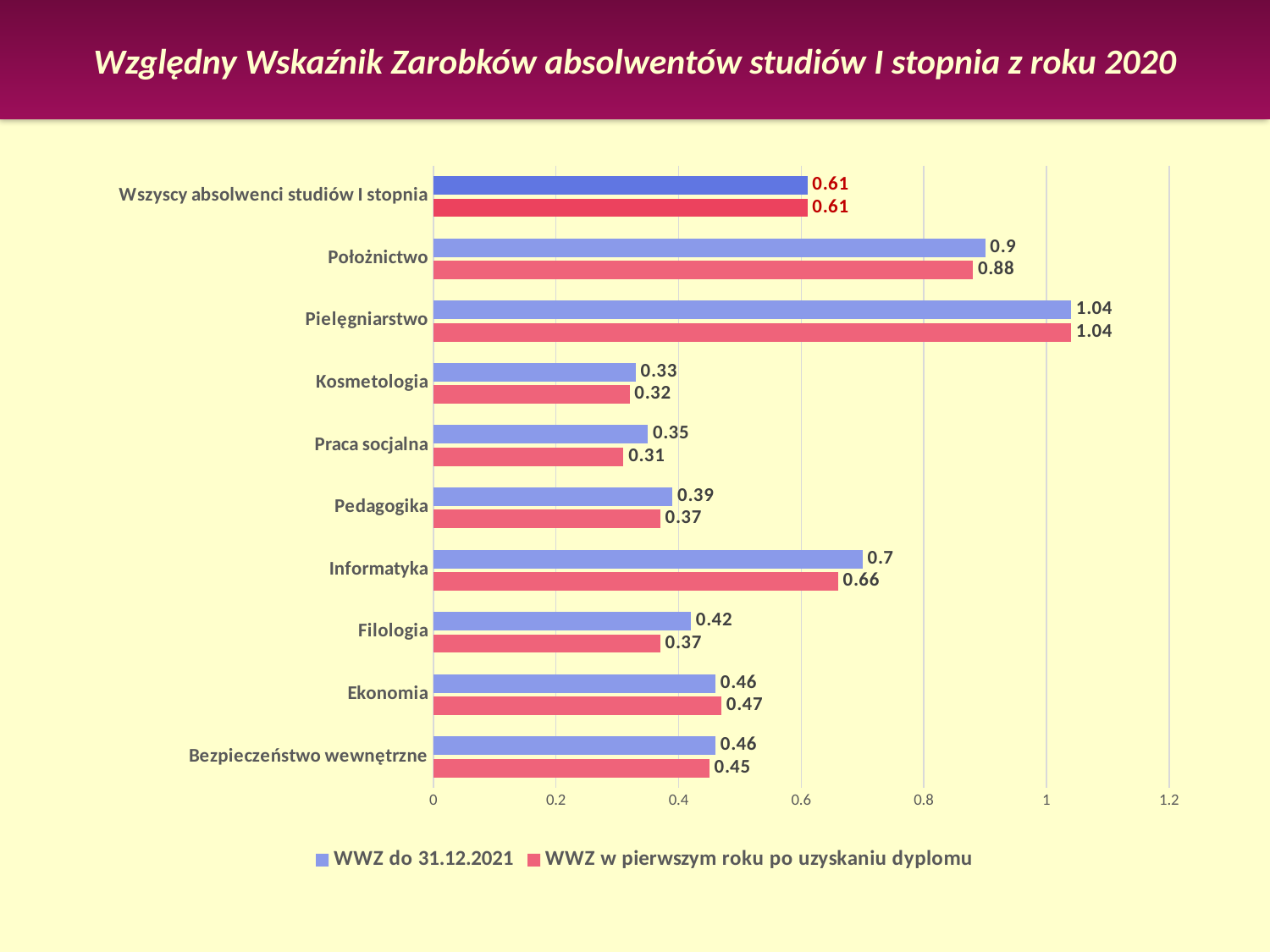
What is the value of "WWZ w pierwszym roku po uzyskaniu dyplomu" for Położnictwo? 0.88 Which is larger for Ekonomia: "WWZ do 31.12.2021" or "WWZ w pierwszym roku po uzyskaniu dyplomu"? WWZ w pierwszym roku po uzyskaniu dyplomu What kind of chart is shown on the slide? bar chart What is the value of "WWZ do 31.12.2021" for Informatyka? 0.7 Is the "WWZ do 31.12.2021" value for Położnictwo greater or less than 0.8? greater How many series does the legend list? 2 What is the value of "WWZ do 31.12.2021" for Wszyscy absolwenci studiów I stopnia? 0.61 How many categories are shown on the chart? 10 Which category has the highest value for "WWZ do 31.12.2021"? Pielęgniarstwo What is the title of the chart? Względny Wskaźnik Zarobków absolwentów studiów I stopnia z roku 2020 What is the difference between the "WWZ do 31.12.2021" and "WWZ w pierwszym roku po uzyskaniu dyplomu" values for Filologia? 0.05 Which category has the lowest value for "WWZ w pierwszym roku po uzyskaniu dyplomu"? Praca socjalna